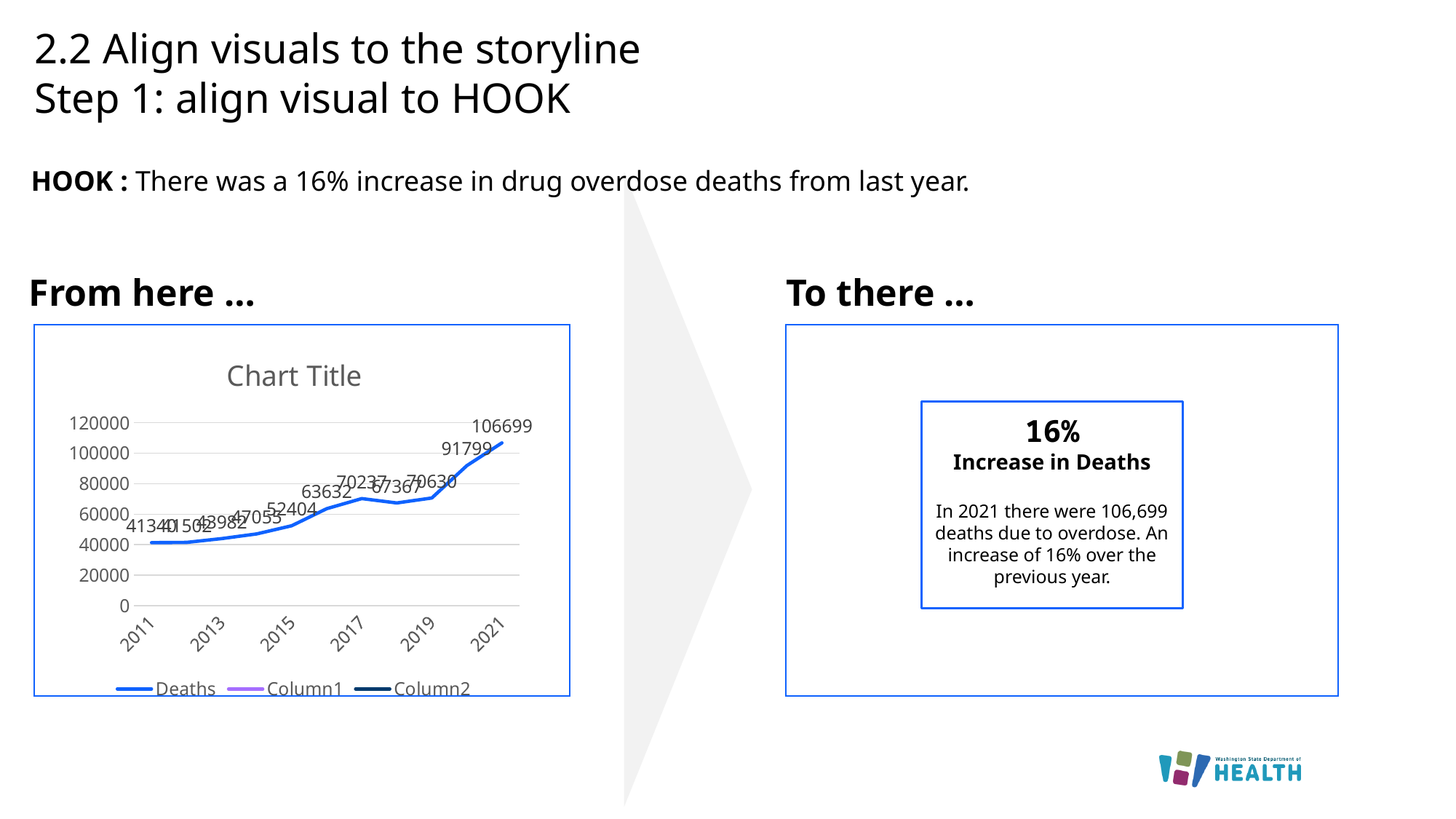
In the left chart, is the value for 2013 greater or less than 60000? less What kind of chart is shown on the left under "From here ..."? line chart In the left chart, do the values generally rise or fall from 2011 to 2021? rise In the left chart, which year has the highest value? 2021 In the left chart, what is the value for the point just before 2021 (2020)? 91799 How many data points are plotted in the left chart? 11 In the left chart, which is larger: the value for 2015 or the value for 2021? 2021 In the left chart, what is the value for 2015? 52404 How many series does the legend of the left chart list? 3 In the left chart, what is the value for 2021? 106699 In the left chart, what is the difference between the 2021 value and the 2020 value? 14900 What is the title shown on the left chart? Chart Title